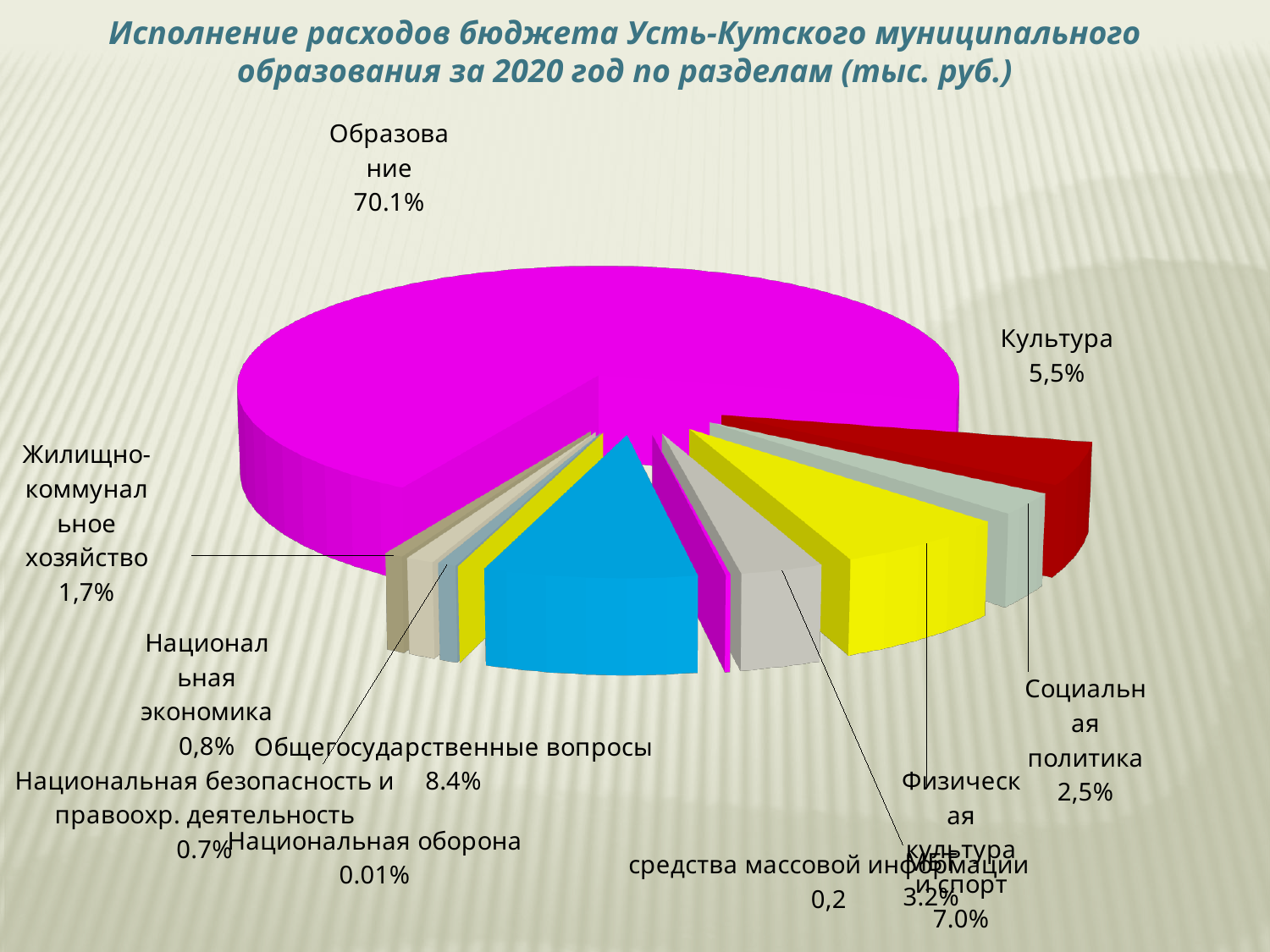
What is the value shown for Физическая культура и спорт? 7.0% What share of the pie does Образование account for? 70.1% Which category has the smallest share of the pie? Национальная оборона What year does the chart title say the budget expenditure data is for? 2020 Which category has the largest share of the pie? Образование What is the value shown for Общегосударственные вопросы? 8.4% What is the value shown for Социальная политика? 2,5% What is the value shown for Жилищно-коммунальное хозяйство? 1,7% Which is larger, Общегосударственные вопросы or Физическая культура и спорт? Общегосударственные вопросы What is the value shown for Культура? 5,5% What kind of chart is shown on the slide? Pie chart What is the value shown for Национальная оборона? 0.01%